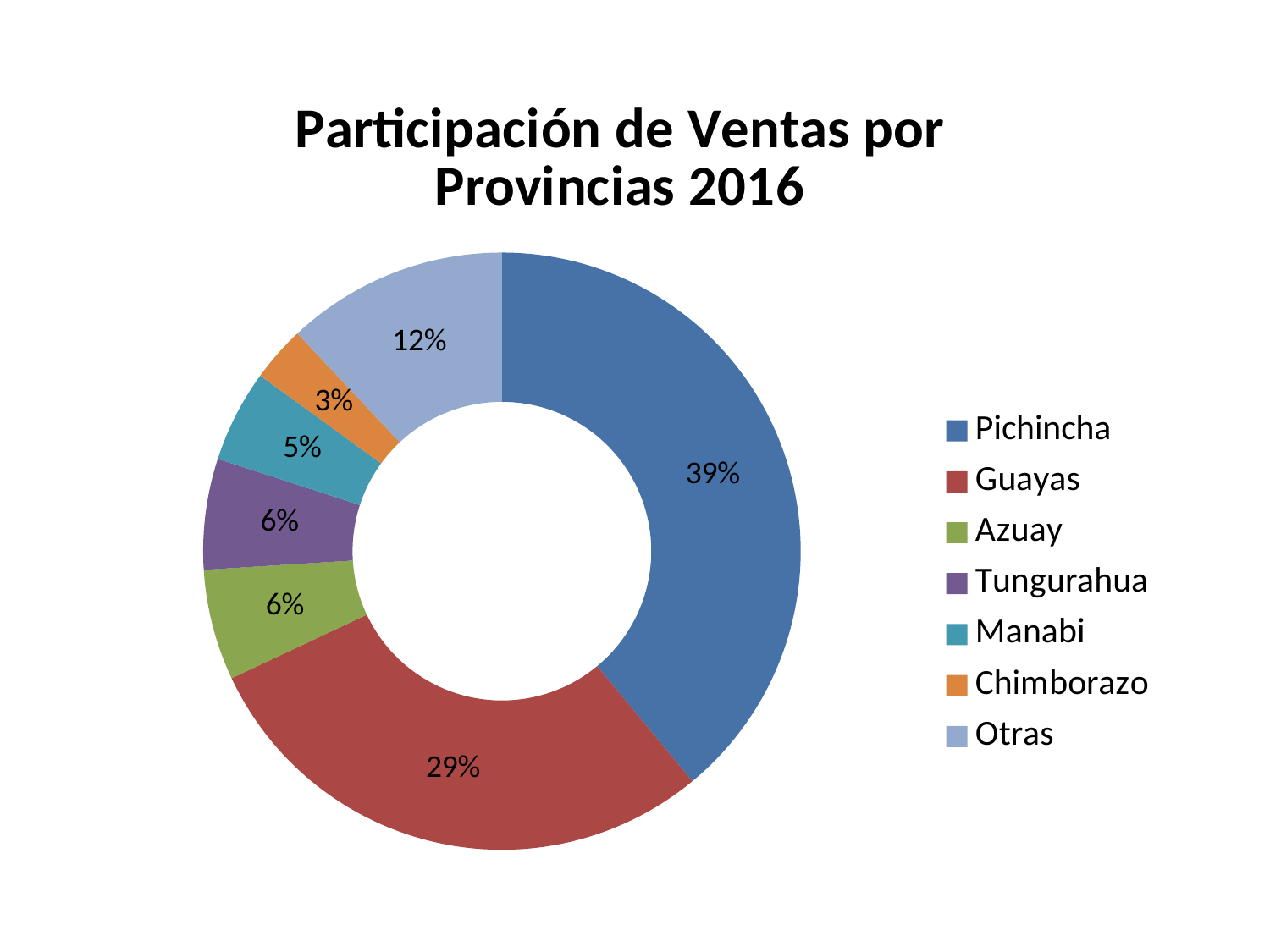
What share of sales does Chimborazo have? 3% Which province has the smallest share of sales? Chimborazo Which has a larger share of sales, Otras or Manabi? Otras Which province has the largest share of sales? Pichincha What is the title of the chart? Participación de Ventas por Provincias 2016 What share of sales does Guayas have? 29% What kind of chart is shown on the slide? Pie chart (doughnut) How many categories does the legend list? 7 What share of sales does Pichincha have? 39% What share of sales does Otras have? 12% What share of sales does Manabi have? 5% What is the difference between the shares of Pichincha and Guayas? 10%